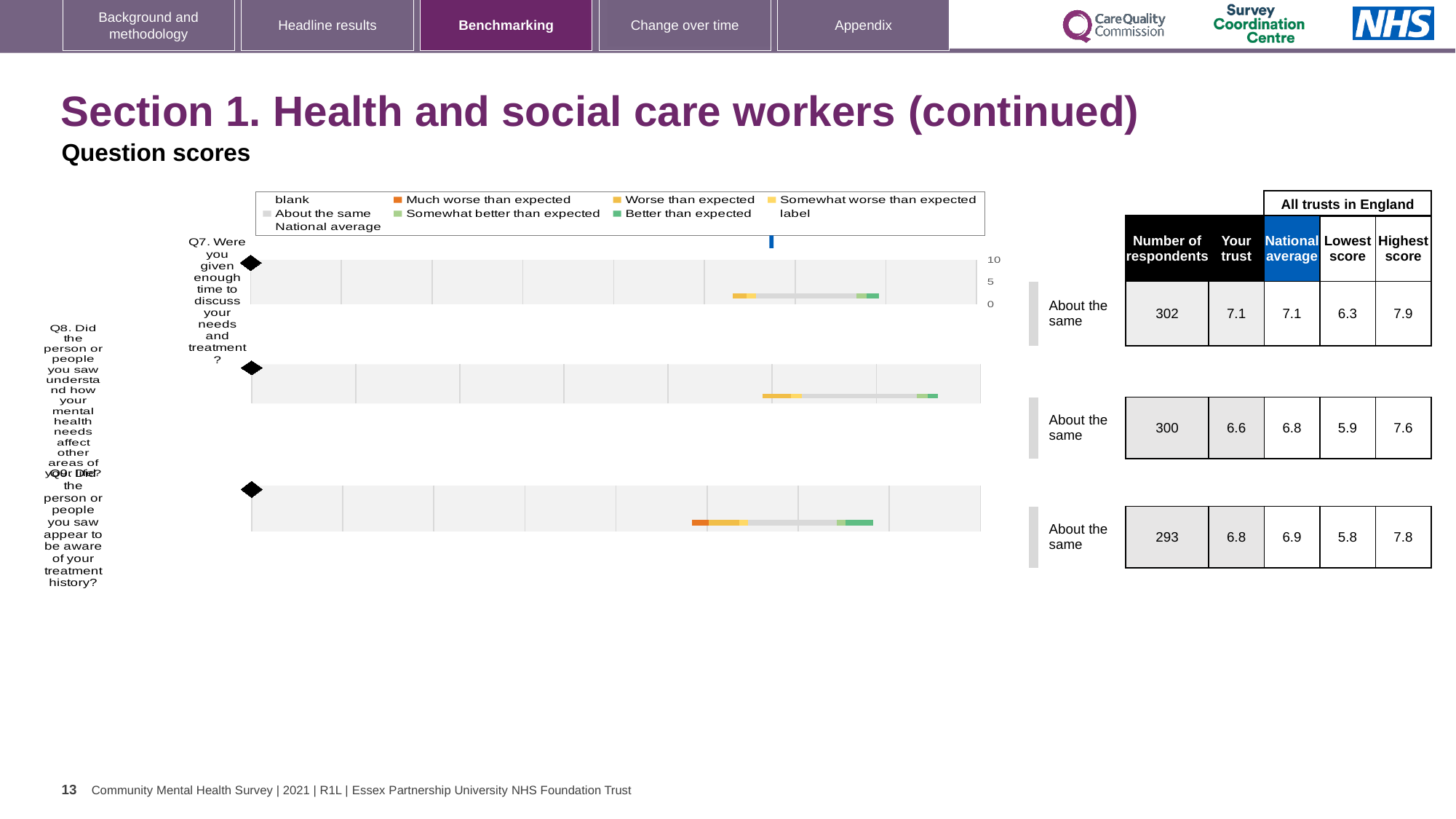
What kind of chart is used to show the question scores? Bar chart How many respondents answered Q9 (Did the person or people you saw appear to be aware of your treatment history?)? 293 How many questions are plotted on this slide? 3 Which question has the highest 'Your trust' score on this slide? Q7 What benchmark category is the trust's score for Q8 placed in? About the same Which question has the lowest 'Lowest score' among all trusts in England? Q9 For Q7, what is the difference between the highest score (7.9) and the lowest score (6.3) across all trusts? 1.6 What is the 'Your trust' score for Q7 (Were you given enough time to discuss your needs and treatment?)? 7.1 Is the 'Your trust' score for Q7 greater or less than 5 on the chart axis? greater What is the national average score for Q8 (Did the person or people you saw understand how your mental health needs affect other areas of your life?)? 6.8 For Q9, which is larger: the 'Your trust' score or the national average? National average For Q8, what is the difference between the highest score and the lowest score across all trusts in England? 1.7